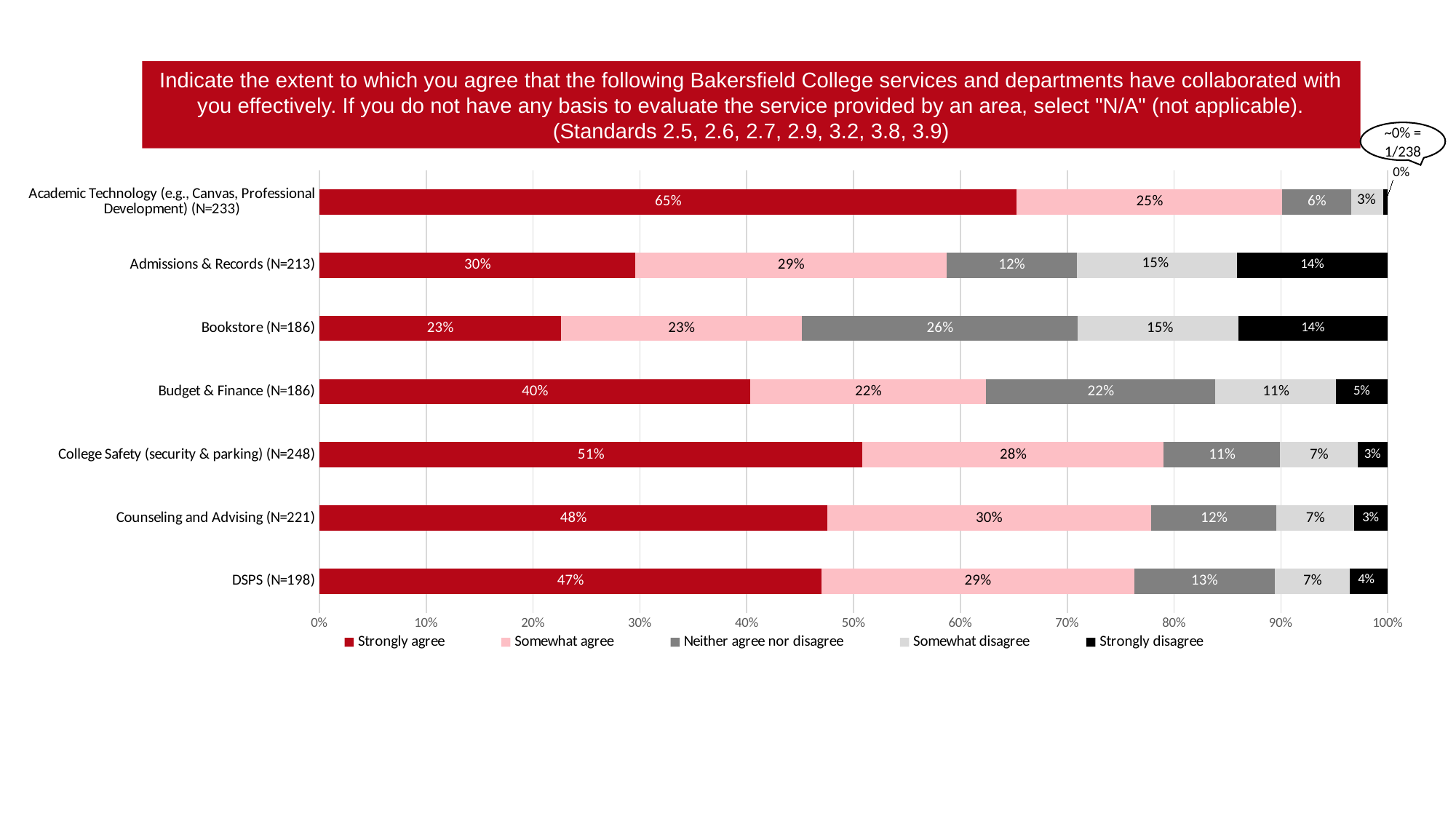
Which has a larger Somewhat agree value: Counseling and Advising (N=221) or DSPS (N=198)? Counseling and Advising (N=221) How many categories (services/departments) are shown on the chart? 7 What is the Somewhat disagree value for Admissions & Records (N=213)? 15% Which category has the highest Strongly agree percentage? Academic Technology (e.g., Canvas, Professional Development) (N=233) What is the total of the stacked bar for Admissions & Records (N=213)? 100% What is the difference between the Strongly agree values for College Safety (security & parking) (N=248) and Counseling and Advising (N=221)? 3% What is the Strongly disagree value for Budget & Finance (N=186)? 5% How many series does the legend list? 5 What kind of chart is shown on the slide? Stacked bar chart What is the Neither agree nor disagree value for Bookstore (N=186)? 26% What percentage of respondents strongly agree for Academic Technology (e.g., Canvas, Professional Development) (N=233)? 65% Which category has the lowest Strongly agree percentage? Bookstore (N=186)